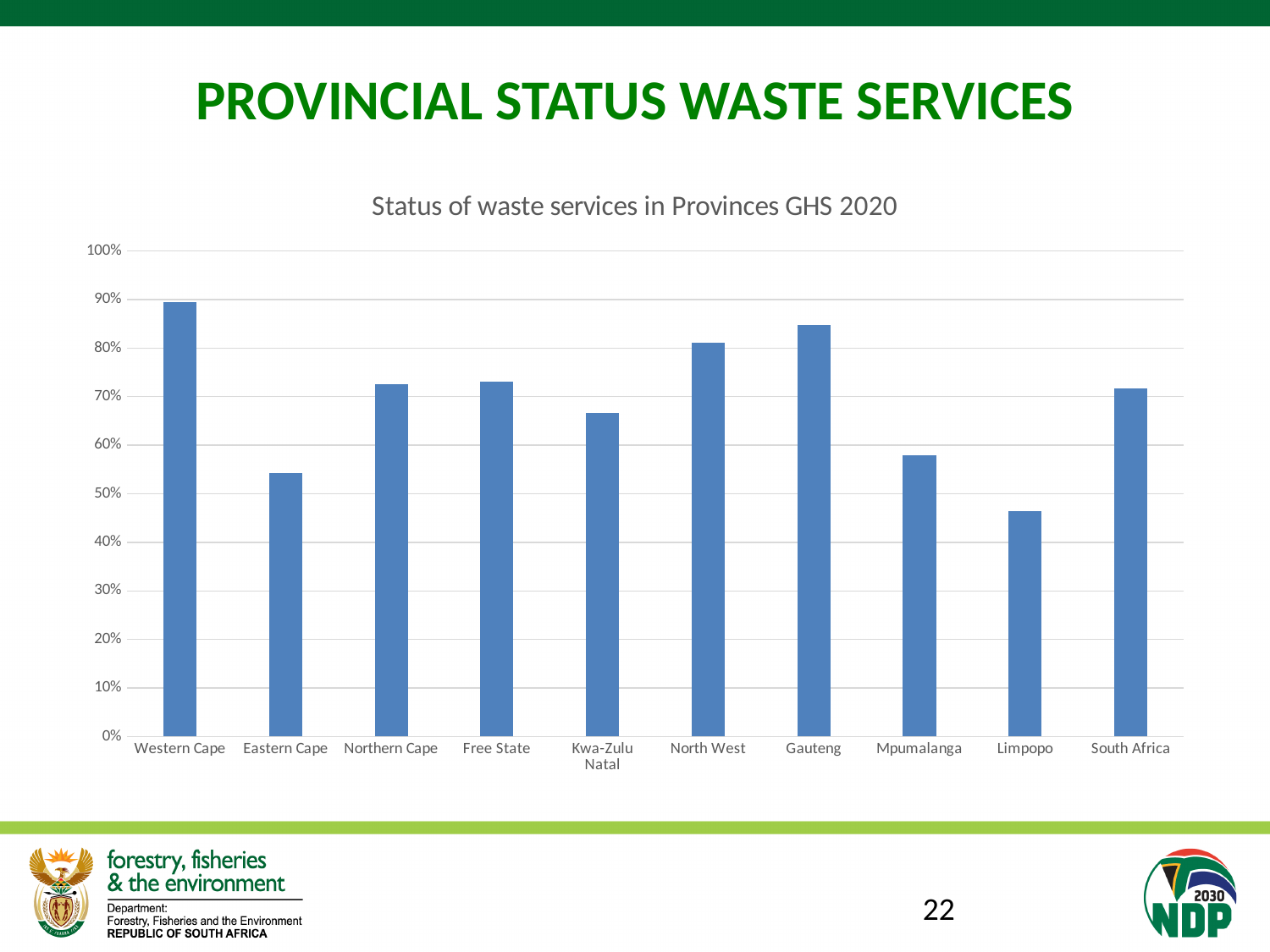
Is the value for Mpumalanga greater or less than 60%? less Is the value for Eastern Cape greater or less than 50%? greater Which category has the lowest value in the chart? Limpopo Is the value for Western Cape greater or less than 80%? greater Which category has the highest value in the chart? Western Cape What type of chart is shown on the slide? bar chart Which has a higher value, Gauteng or North West? Gauteng Which has a higher value, Kwa-Zulu Natal or South Africa? South Africa How many categories are shown on the x axis of the chart? 10 What is the title of the chart? Status of waste services in Provinces GHS 2020